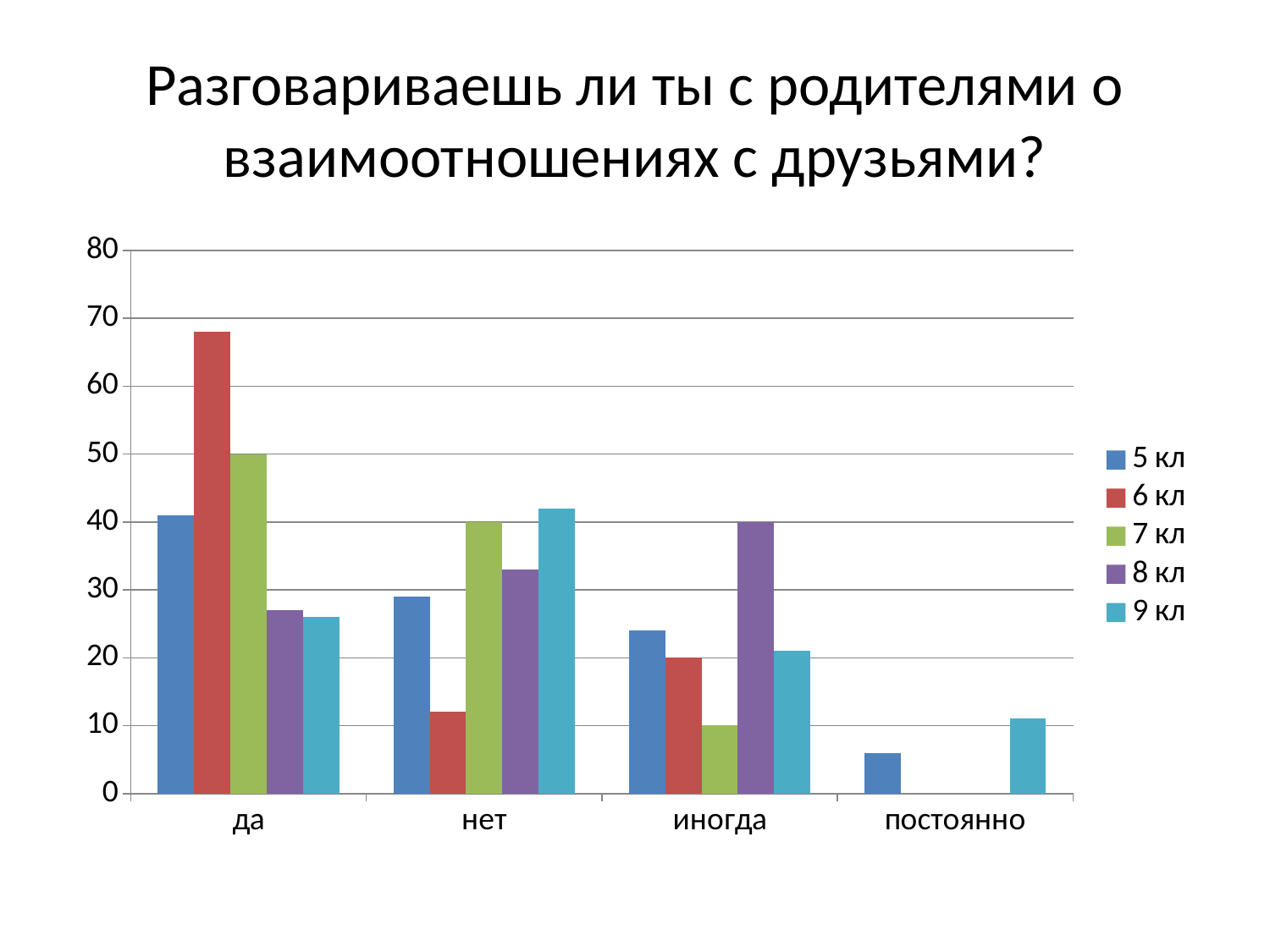
In the category "иногда", which is larger: the value for 5 кл or the value for 7 кл? 5 кл How many categories are shown on the x axis? 4 What is the value for 8 кл in the category "иногда"? 40 Which series has the highest value in the category "да"? 6 кл What is the value for 7 кл in the category "да"? 50 Is the value for 9 кл in the category "постоянно" greater or less than 20? less Is the value for 6 кл in the category "да" greater or less than 60? greater Which series has the lowest value in the category "нет"? 6 кл What kind of chart is shown on the slide? bar chart What is the title of the chart? Разговариваешь ли ты с родителями о взаимоотношениях с друзьями? What is the value for 7 кл in the category "нет"? 40 How many series does the legend list? 5